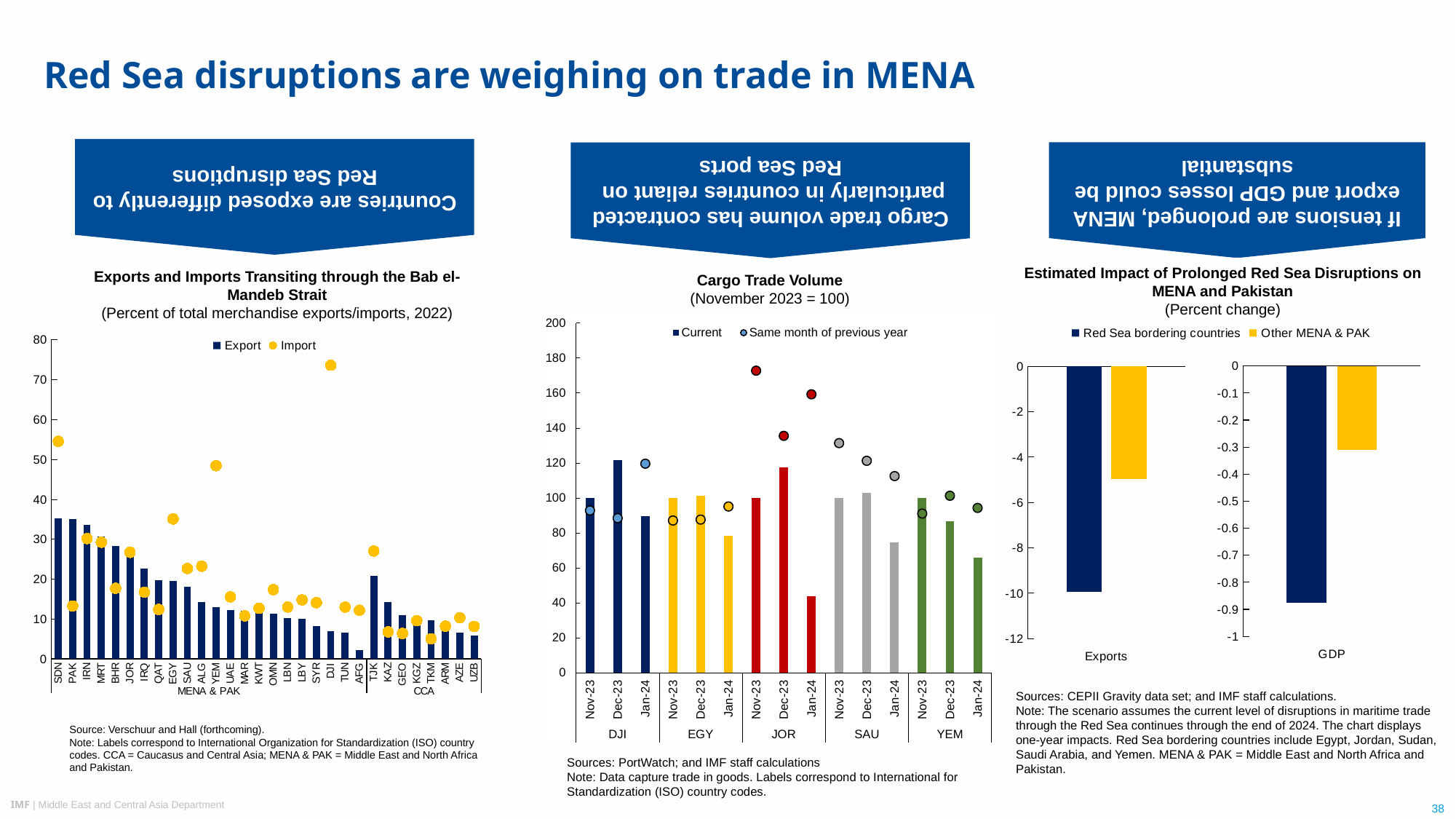
In the 'Cargo Trade Volume' chart, do the Current values for SAU rise or fall from Nov-23 to Jan-24? Fall In the 'Cargo Trade Volume' chart, is the Current value for JOR in Jan-24 greater or less than 60? less In the 'Exports and Imports Transiting through the Bab el-Mandeb Strait' chart, is the Export value for AFG greater or less than 10? less In the 'Estimated Impact of Prolonged Red Sea Disruptions on MENA and Pakistan' chart, is the GDP value for Other MENA & PAK greater or less than -0.5? greater How many series does the legend of the 'Exports and Imports Transiting through the Bab el-Mandeb Strait' chart list? 2 In the 'Cargo Trade Volume' chart, which is larger for DJI in Dec-23: the Current value or the Same month of previous year value? Current What kind of chart is the 'Exports and Imports Transiting through the Bab el-Mandeb Strait' chart? Bar chart with dot markers In the 'Estimated Impact of Prolonged Red Sea Disruptions on MENA and Pakistan' chart, which group shows the larger decline in Exports? Red Sea bordering countries In the 'Cargo Trade Volume' chart, how many countries are shown on the x axis? 5 In the 'Cargo Trade Volume' chart, what is the Current value for JOR in Nov-23? 100 In the 'Exports and Imports Transiting through the Bab el-Mandeb Strait' chart, which country has the highest Import value? DJI